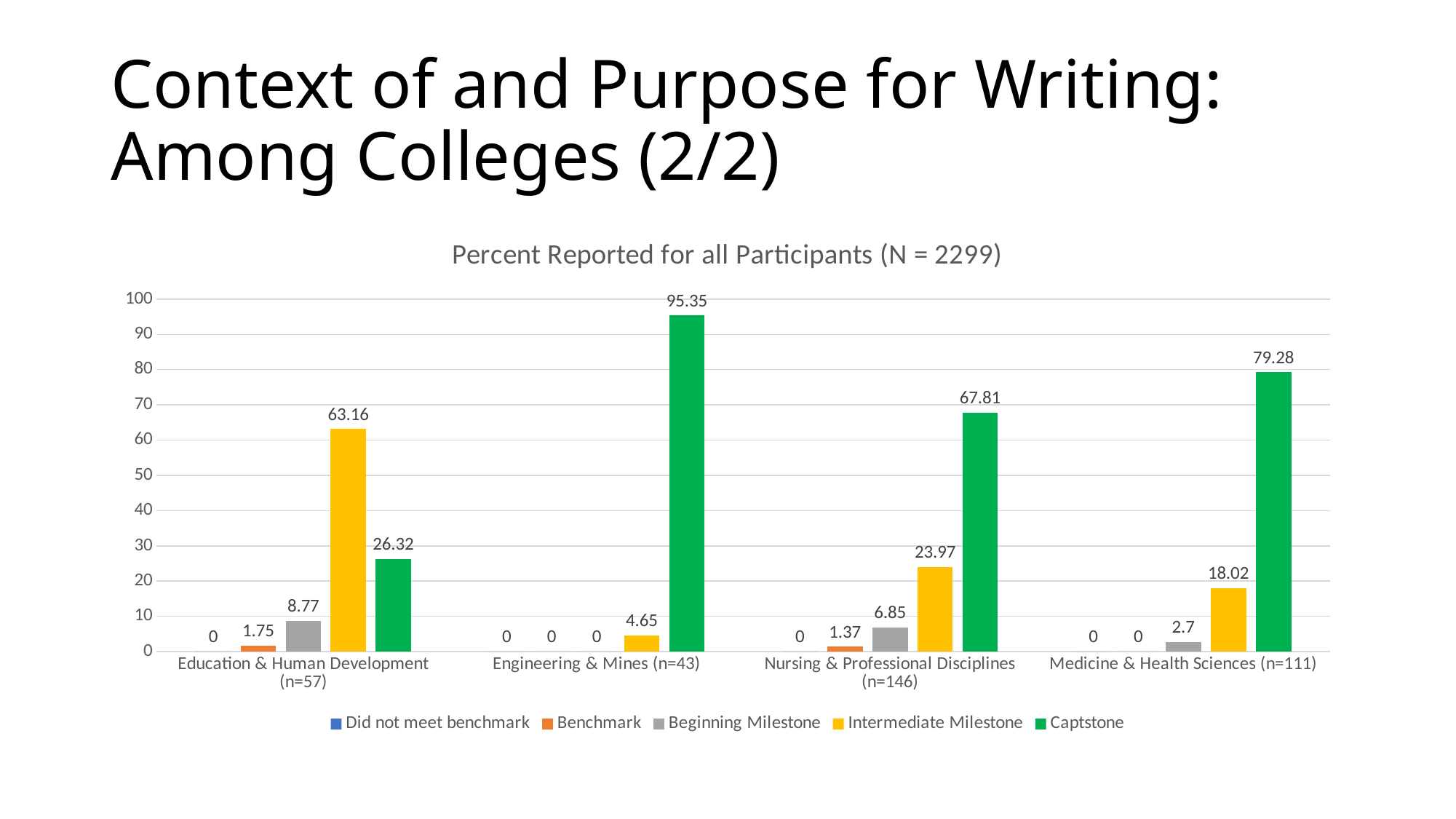
What is the Benchmark value for Medicine & Health Sciences (n=111)? 0 What is the Captstone value for Engineering & Mines (n=43)? 95.35 How many colleges are shown on the x axis? 4 What kind of chart is shown on the slide? Bar chart What is the title of the chart? Percent Reported for all Participants (N = 2299) How many series does the legend list? 5 Which college has the highest Captstone value? Engineering & Mines (n=43) Which is larger for Education & Human Development (n=57): the Intermediate Milestone value or the Captstone value? Intermediate Milestone Which college has the lowest Intermediate Milestone value? Engineering & Mines (n=43) What is the difference between the Captstone values for Medicine & Health Sciences (n=111) and Nursing & Professional Disciplines (n=146)? 11.47 What is the Beginning Milestone value for Nursing & Professional Disciplines (n=146)? 6.85 What is the Intermediate Milestone value for Education & Human Development (n=57)? 63.16